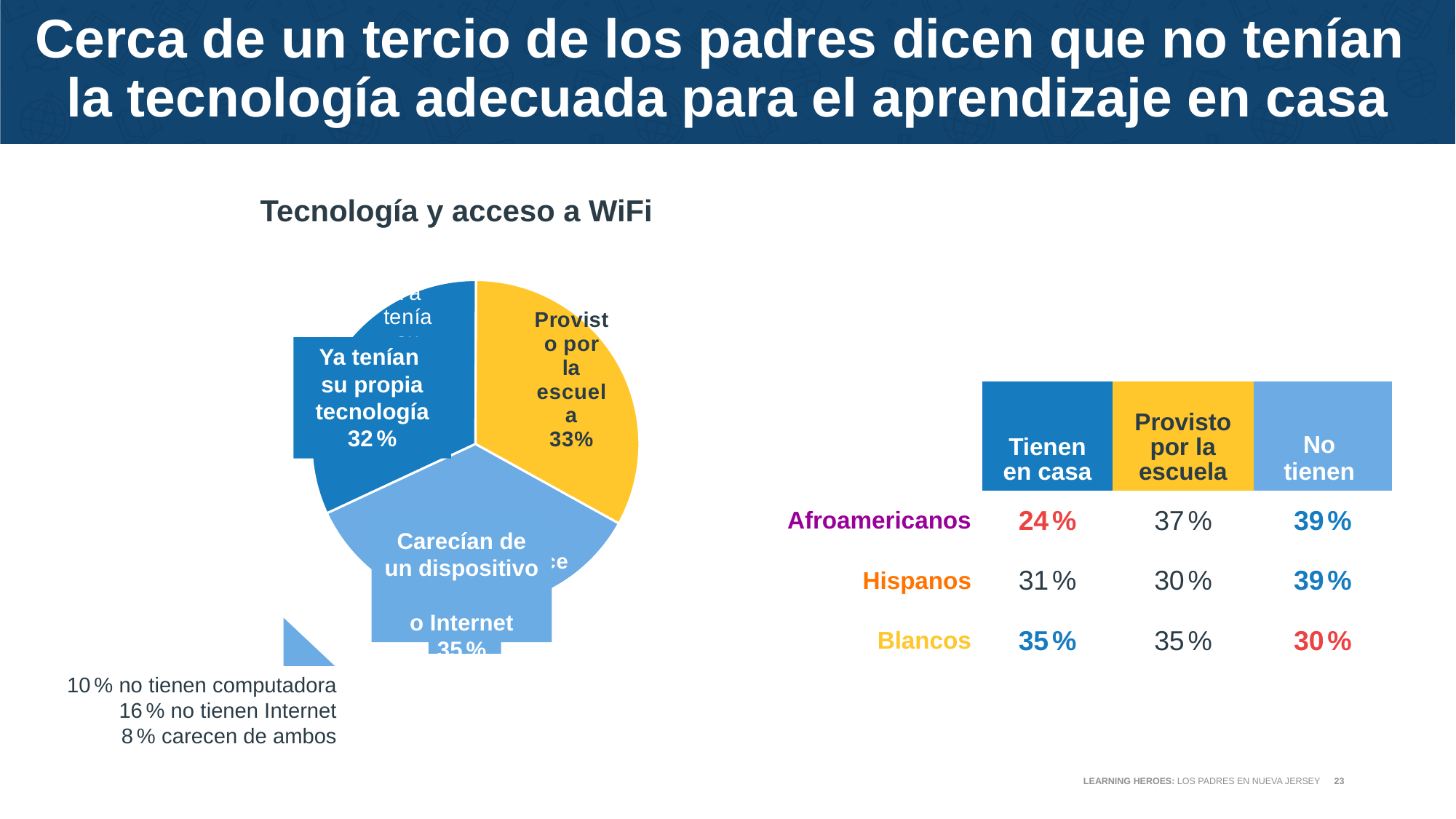
In the pie chart, what percentage of parents said they already had their own technology ('Ya tenían su propia tecnología')? 32% Which slice of the pie chart is the smallest? Ya tenían su propia tecnología In the pie chart, what percentage of parents lacked a device or Internet ('Carecían de un dispositivo o Internet')? 35% In the pie chart, which is larger: 'Provisto por la escuela' or 'Ya tenían su propia tecnología'? Provisto por la escuela How many slices does the pie chart have? 3 What is the title of the pie chart? Tecnología y acceso a WiFi What colour is the 'Provisto por la escuela' slice of the pie chart? yellow What type of chart is shown under the heading 'Tecnología y acceso a WiFi'? pie chart Which slice of the pie chart is the largest? Carecían de un dispositivo o Internet According to the note below the pie chart, what percentage of parents do not have Internet? 16% In the pie chart, what is the difference in percentage points between 'Carecían de un dispositivo o Internet' and 'Ya tenían su propia tecnología'? 3 In the pie chart, what percentage corresponds to 'Provisto por la escuela'? 33%